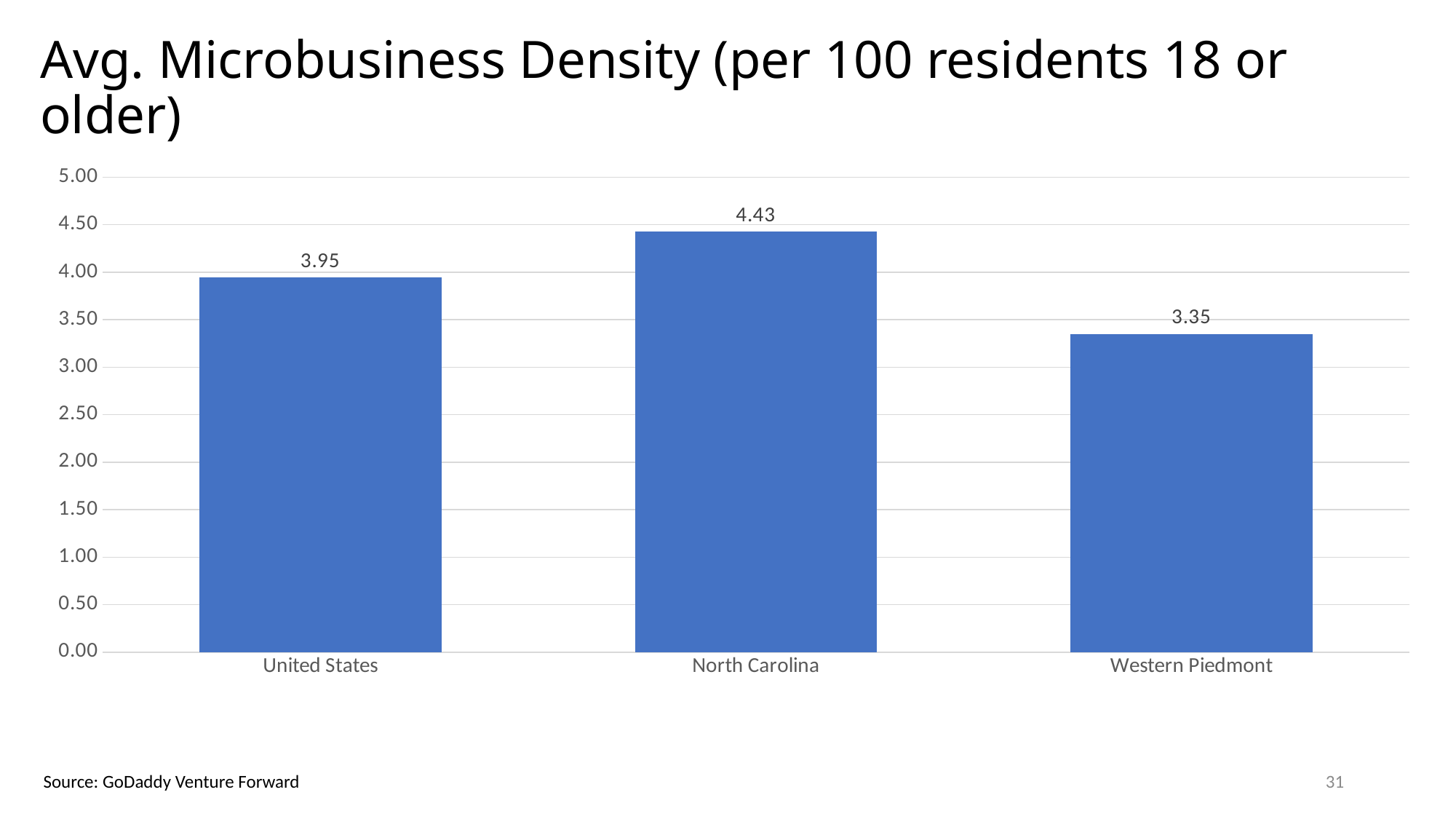
What kind of chart is shown on the slide? bar chart Which category has the lowest average microbusiness density? Western Piedmont What is the difference between the North Carolina and Western Piedmont values? 1.08 What is the average microbusiness density for the United States? 3.95 Is the value for Western Piedmont greater or less than 3.50? less What is the difference between the North Carolina and United States values? 0.48 What is the source cited for the chart? GoDaddy Venture Forward How many categories are shown on the chart? 3 Which is larger, the value for the United States or the value for Western Piedmont? United States Which category has the highest average microbusiness density? North Carolina What is the average microbusiness density for North Carolina? 4.43 What is the average microbusiness density for Western Piedmont? 3.35